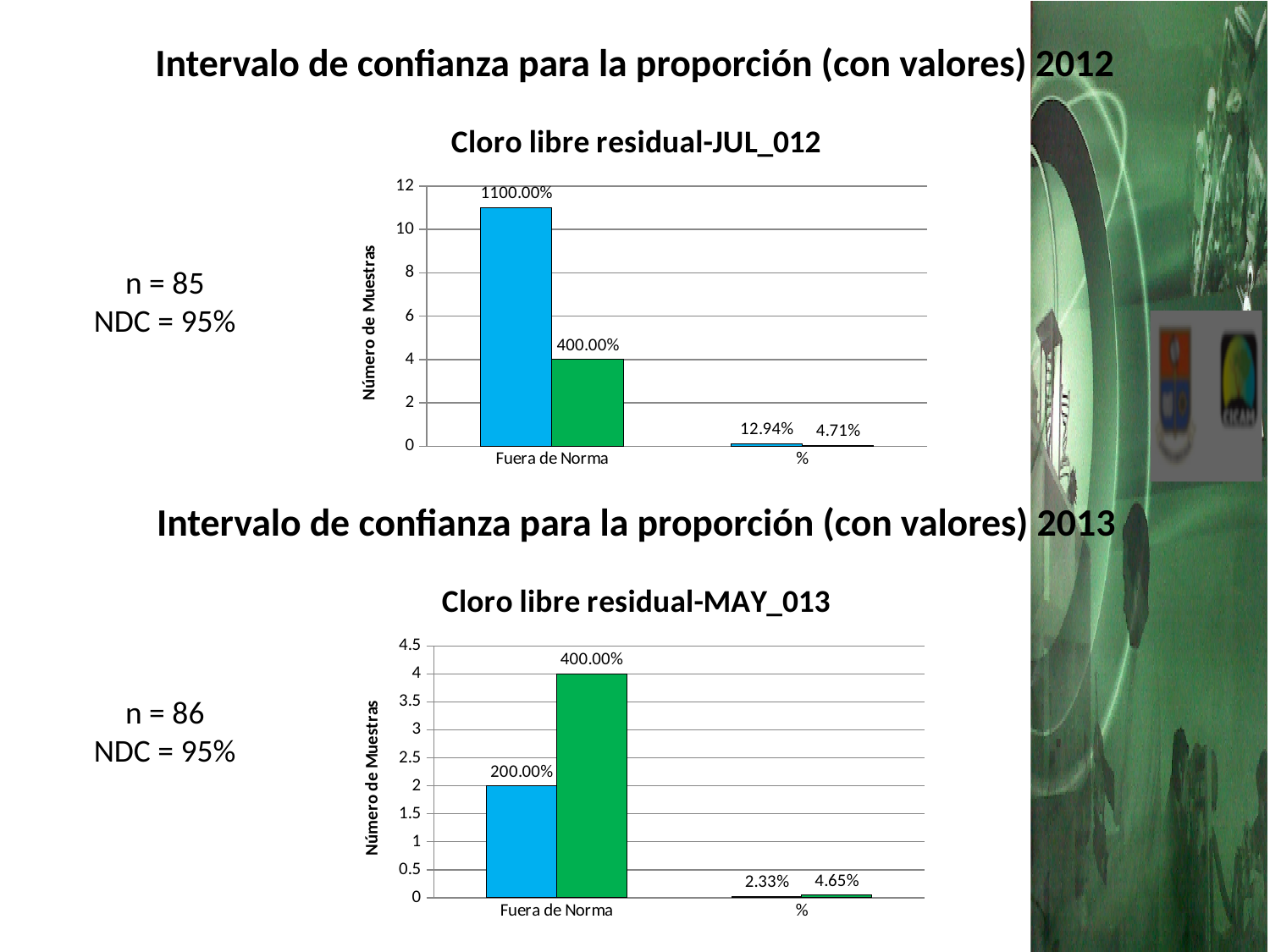
In the chart titled "Cloro libre residual-MAY_013", what is the data label on the blue bar for "Fuera de Norma"? 200.00% In the chart titled "Cloro libre residual-JUL_012", which bar has the highest data label? The blue bar for Fuera de Norma In the chart titled "Cloro libre residual-MAY_013", which is larger for "Fuera de Norma": the blue bar or the green bar? The green bar In the chart titled "Cloro libre residual-JUL_012", what is the data label on the green bar for "Fuera de Norma"? 400.00% How many categories are shown on the x axis of the chart titled "Cloro libre residual-MAY_013"? 2 In the chart titled "Cloro libre residual-JUL_012", what is the data label on the blue bar for "Fuera de Norma"? 1100.00% In the chart titled "Cloro libre residual-JUL_012", what is the data label on the green bar for the "%" category? 4.71% In the chart titled "Cloro libre residual-MAY_013", what is the data label on the green bar for "Fuera de Norma"? 400.00% In the chart titled "Cloro libre residual-JUL_012", what is the data label on the blue bar for the "%" category? 12.94% What kind of chart is "Cloro libre residual-JUL_012"? Bar chart In the chart titled "Cloro libre residual-MAY_013", what is the data label on the blue bar for the "%" category? 2.33% In the chart titled "Cloro libre residual-MAY_013", what is the data label on the green bar for the "%" category? 4.65%